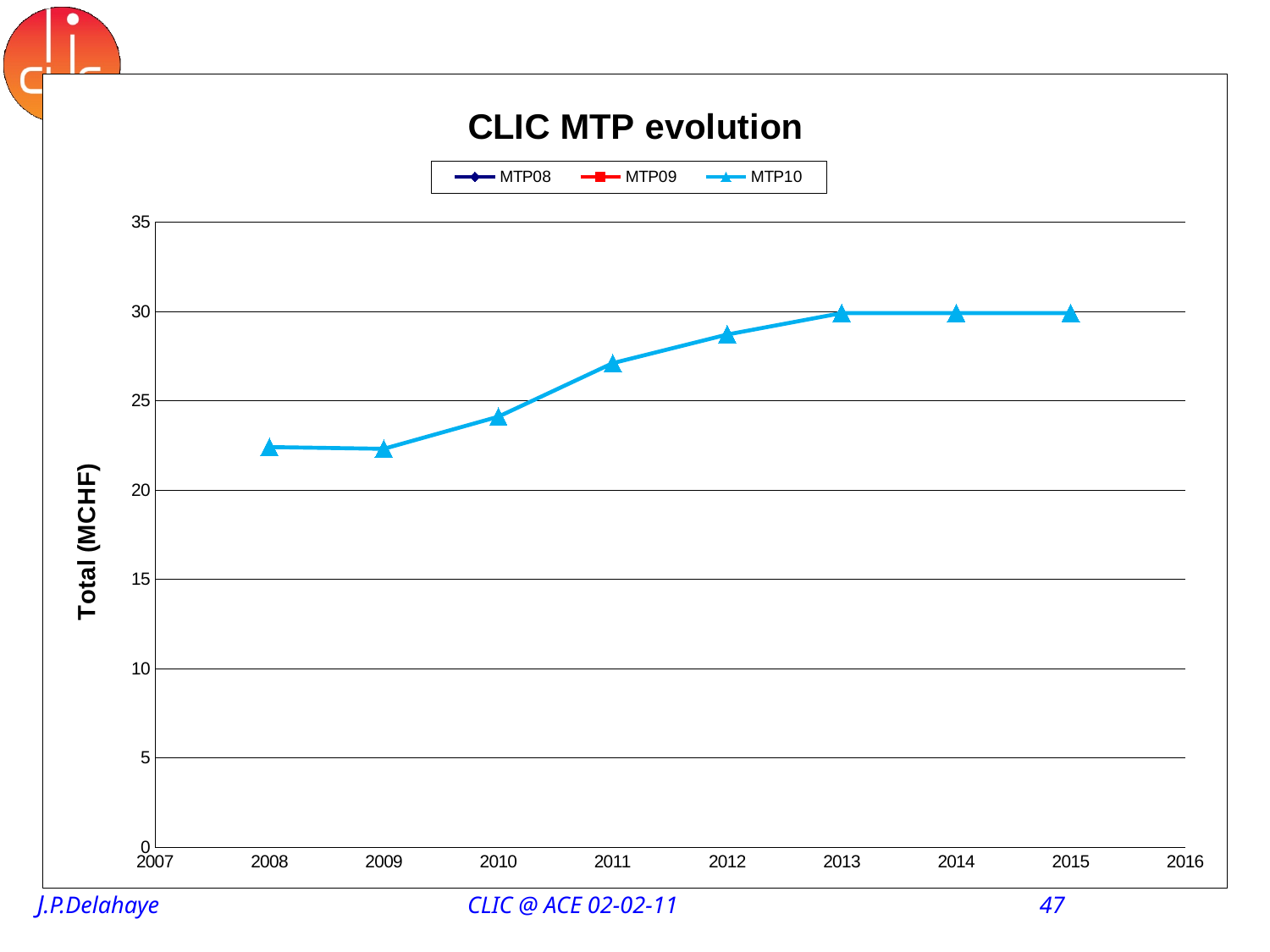
Is the MTP10 value for 2008 greater or less than 20? greater Is the MTP10 value for 2010 greater or less than 25? less Is the MTP10 value for 2012 greater or less than 30? less What is the title of the chart? CLIC MTP evolution How many series does the legend list? 3 How many data points are plotted for the MTP10 series? 8 Does the MTP10 series rise or fall from 2009 to 2013? rise What is the label of the vertical axis? Total (MCHF) What kind of chart is shown on the slide? line chart Which is larger for MTP10, the value for 2009 or the value for 2011? 2011